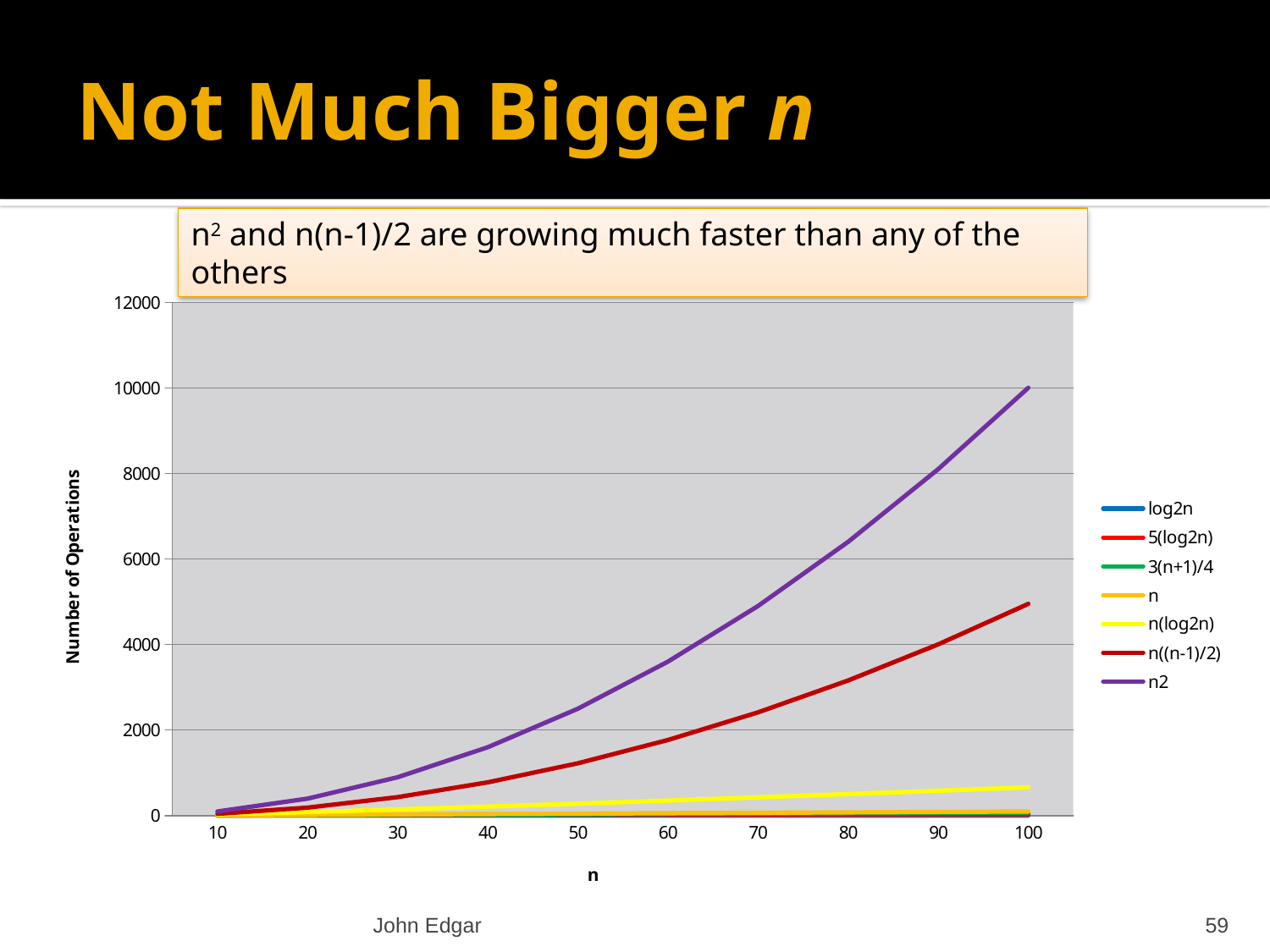
At n = 100, which is larger: n2 or n((n-1)/2)? n2 Is the value of n2 at n = 70 greater or less than 4000? greater How many series does the legend list? 7 What kind of chart is shown on the slide? line chart Is the value of n((n-1)/2) at n = 100 greater or less than 4000? greater Is the value of n((n-1)/2) at n = 100 greater or less than 6000? less What is the value of the n2 series at n = 100? 10000 What is the title of the vertical axis? Number of Operations Does the n2 series rise or fall as n increases from 10 to 100? rise How many values of n are marked along the x axis? 10 Which series has the highest value at n = 100? n2